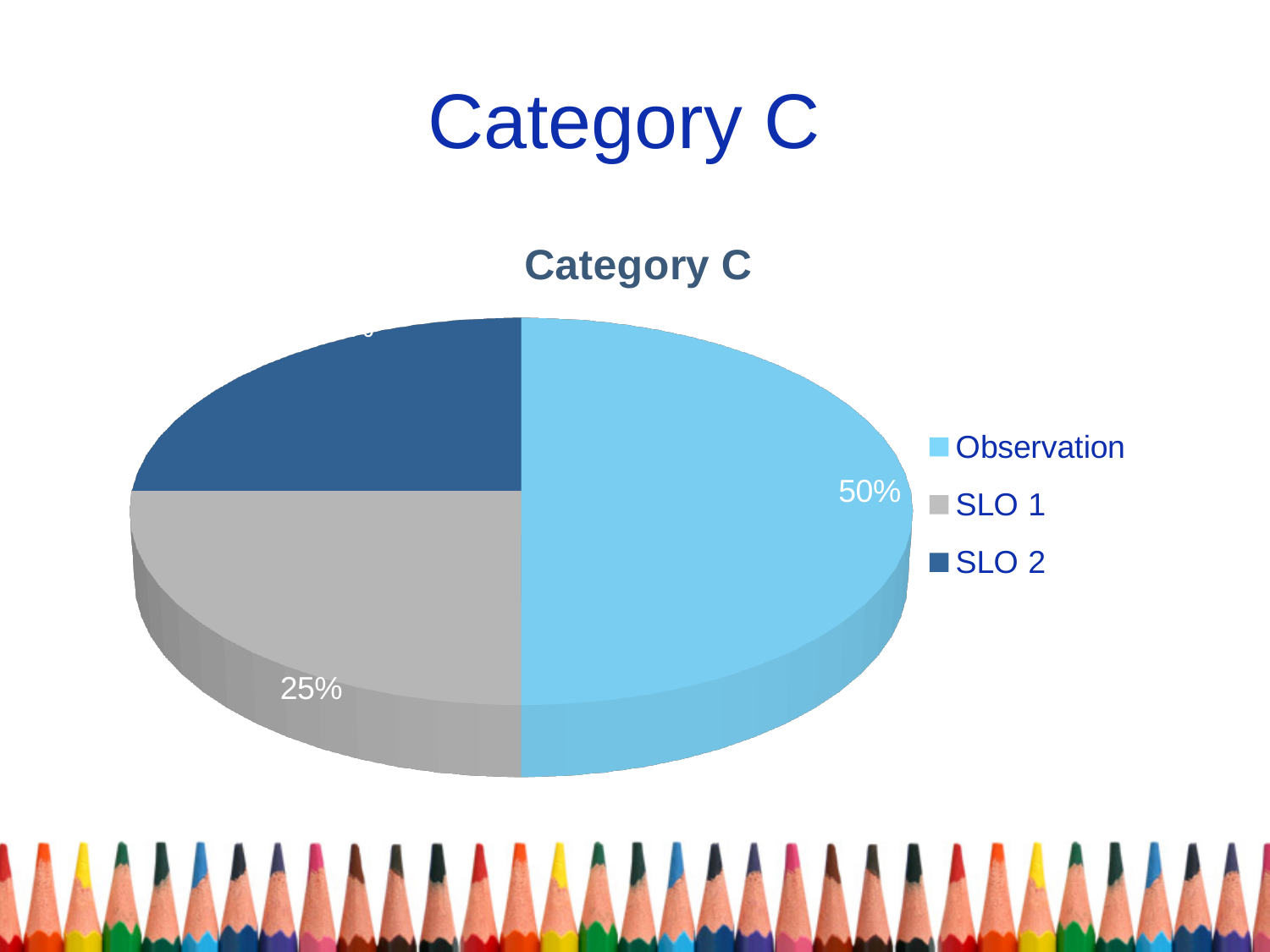
What share of the pie is taken by Observation? 50% Which category has the largest slice of the pie? Observation What kind of chart is shown on the slide? Pie chart How many slices does the pie chart have? 3 What percentage is shown for SLO 1? 25% Which is larger, the Observation slice or the SLO 1 slice? Observation What is the difference in percentage points between the Observation slice and the SLO 1 slice? 25% What is the title of the chart? Category C Which legend entry is shown in the darkest blue colour? SLO 2 How many entries does the legend list? 3 What percentage of the pie does the Observation slice represent? 50%